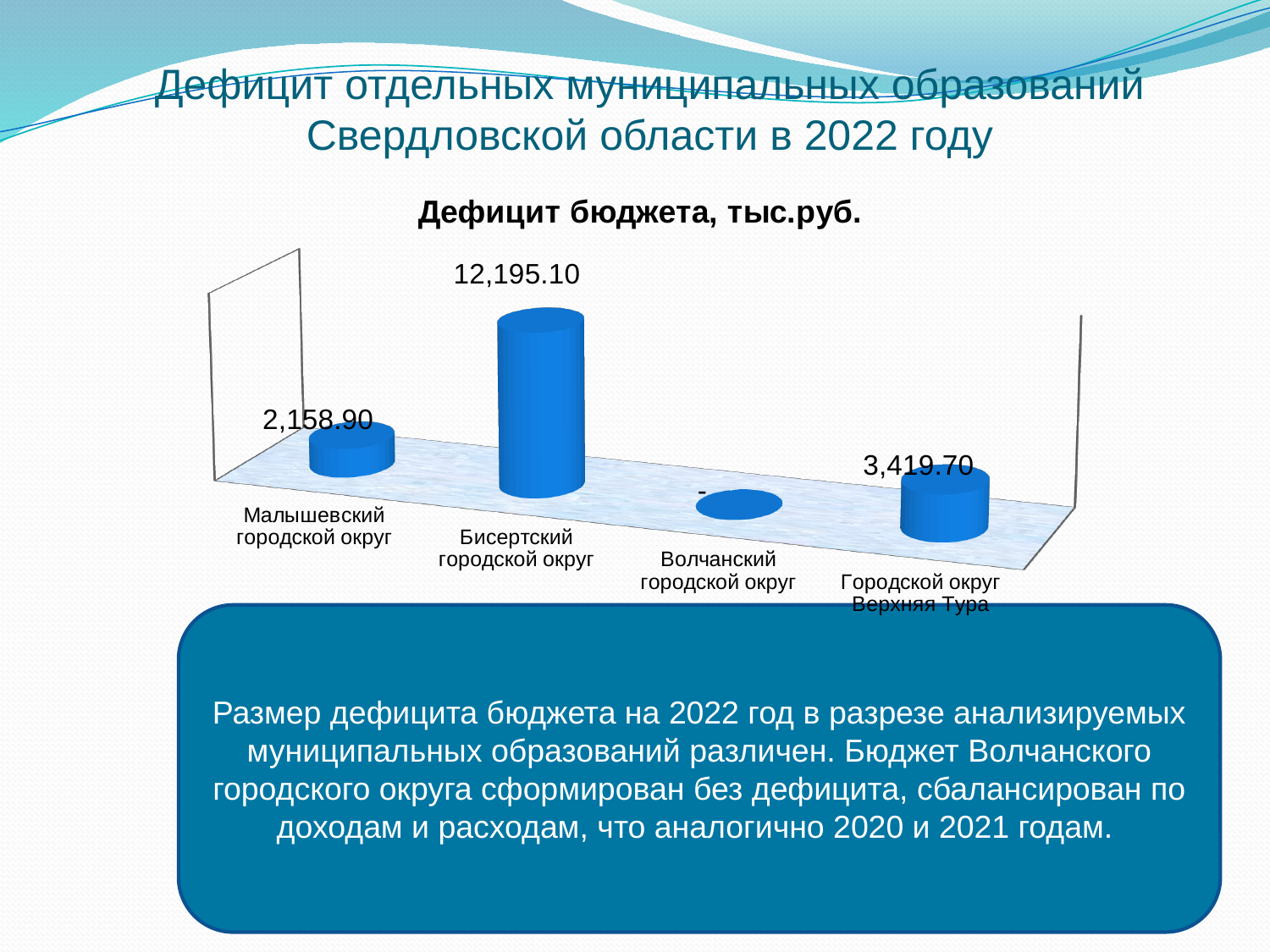
How many municipalities are shown on the chart? 4 Which municipality has the highest budget deficit on the chart? Бисертский городской округ What is the difference between the deficit of Бисертский городской округ and Малышевский городской округ? 10,036.20 What is the difference between the deficit of Городской округ Верхняя Тура and Малышевский городской округ? 1,260.80 What data label is shown for Волчанский городской округ? - What is the title of the chart? Дефицит бюджета, тыс.руб. Which has a larger budget deficit: Малышевский городской округ or Городской округ Верхняя Тура? Городской округ Верхняя Тура What is the budget deficit value shown for Бисертский городской округ? 12,195.10 Which municipality has the lowest budget deficit on the chart? Волчанский городской округ What type of chart is shown on the slide? Bar chart What is the budget deficit value shown for Малышевский городской округ? 2,158.90 What is the budget deficit value shown for Городской округ Верхняя Тура? 3,419.70